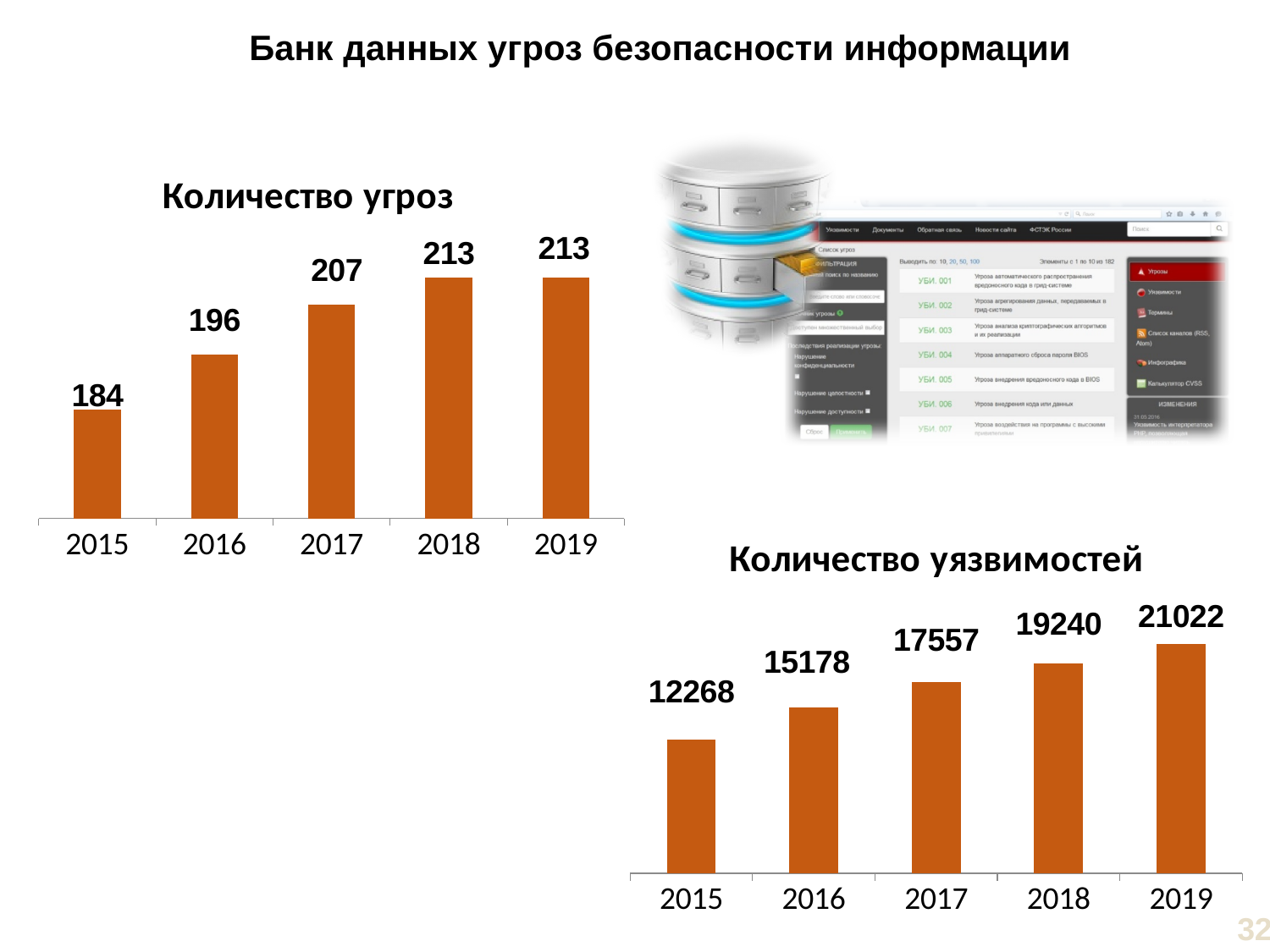
In the chart titled "Количество уязвимостей", what is the value for 2018? 19240 In the chart titled "Количество угроз", how many years are shown on the x axis? 5 In the chart titled "Количество угроз", which year has the lowest value? 2015 In the chart titled "Количество угроз", what is the difference between the values for 2016 and 2015? 12 In the chart titled "Количество уязвимостей", which year has the highest value? 2019 In the chart titled "Количество уязвимостей", what is the value for 2015? 12268 In the chart titled "Количество угроз", do the values rise or fall from 2015 to 2018? rise In the chart titled "Количество уязвимостей", which is larger, the value for 2016 or the value for 2017? 2017 In the chart titled "Количество угроз", what is the value for 2017? 207 In the chart titled "Количество уязвимостей", what is the difference between the values for 2019 and 2015? 8754 What is the title of the chart on the left side of the slide? Количество угроз What kind of chart is the chart titled "Количество уязвимостей"? bar chart